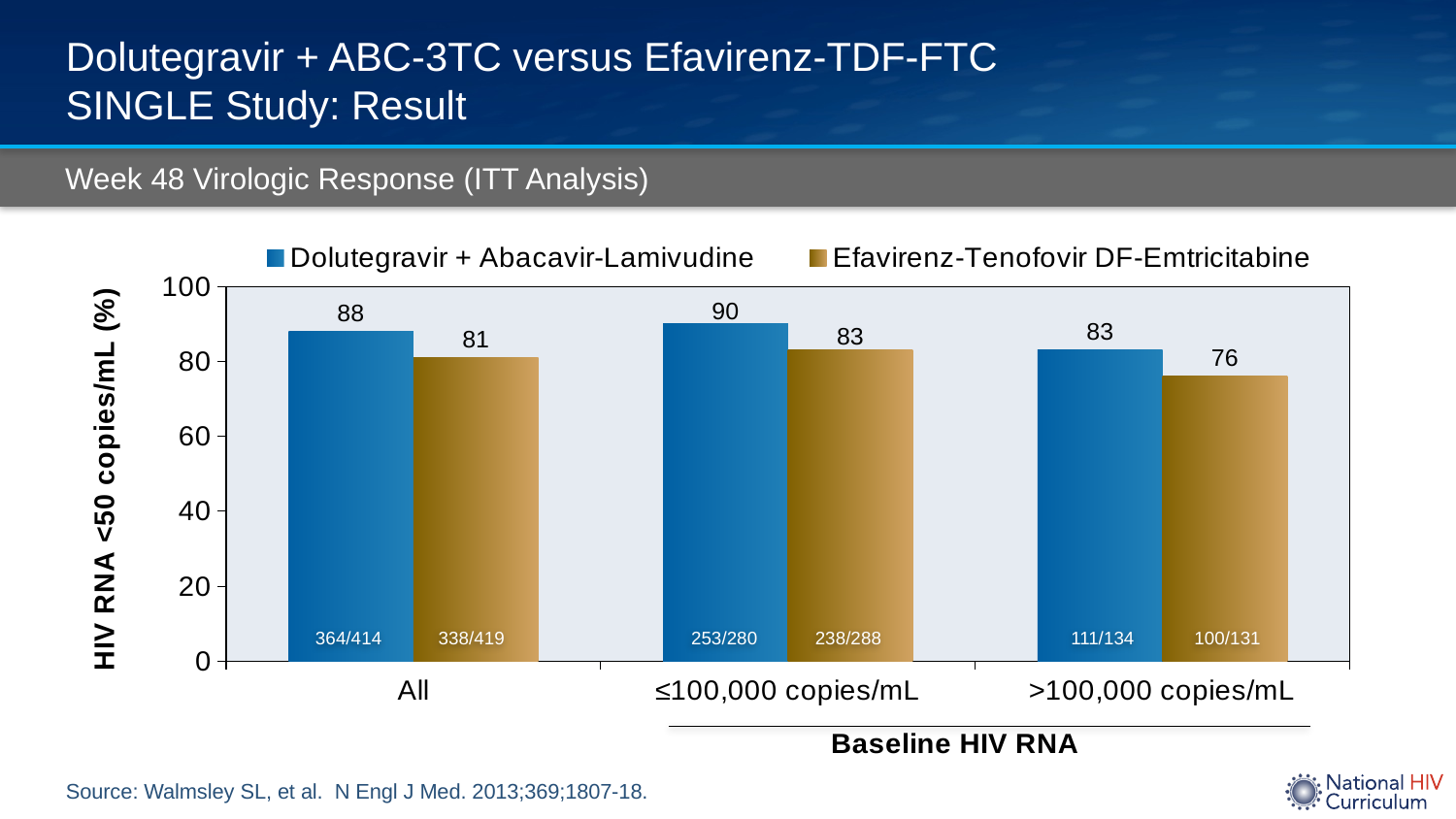
Which category has the highest value for Dolutegravir + Abacavir-Lamivudine? ≤100,000 copies/mL How many series does the legend list? 2 What is the value for Efavirenz-Tenofovir DF-Emtricitabine in the >100,000 copies/mL category? 76 What is the value for Dolutegravir + Abacavir-Lamivudine in the All category? 88 What is the difference between the Dolutegravir + Abacavir-Lamivudine and Efavirenz-Tenofovir DF-Emtricitabine values in the >100,000 copies/mL category? 7 Which series has the larger value in the ≤100,000 copies/mL category? Dolutegravir + Abacavir-Lamivudine What is the difference between the Dolutegravir + Abacavir-Lamivudine and Efavirenz-Tenofovir DF-Emtricitabine values in the All category? 7 What is the value for Efavirenz-Tenofovir DF-Emtricitabine in the ≤100,000 copies/mL category? 83 How many categories are shown on the x axis? 3 Which category has the lowest value for Efavirenz-Tenofovir DF-Emtricitabine? >100,000 copies/mL What kind of chart is shown on the slide? Bar chart What is the label of the y axis? HIV RNA <50 copies/mL (%)